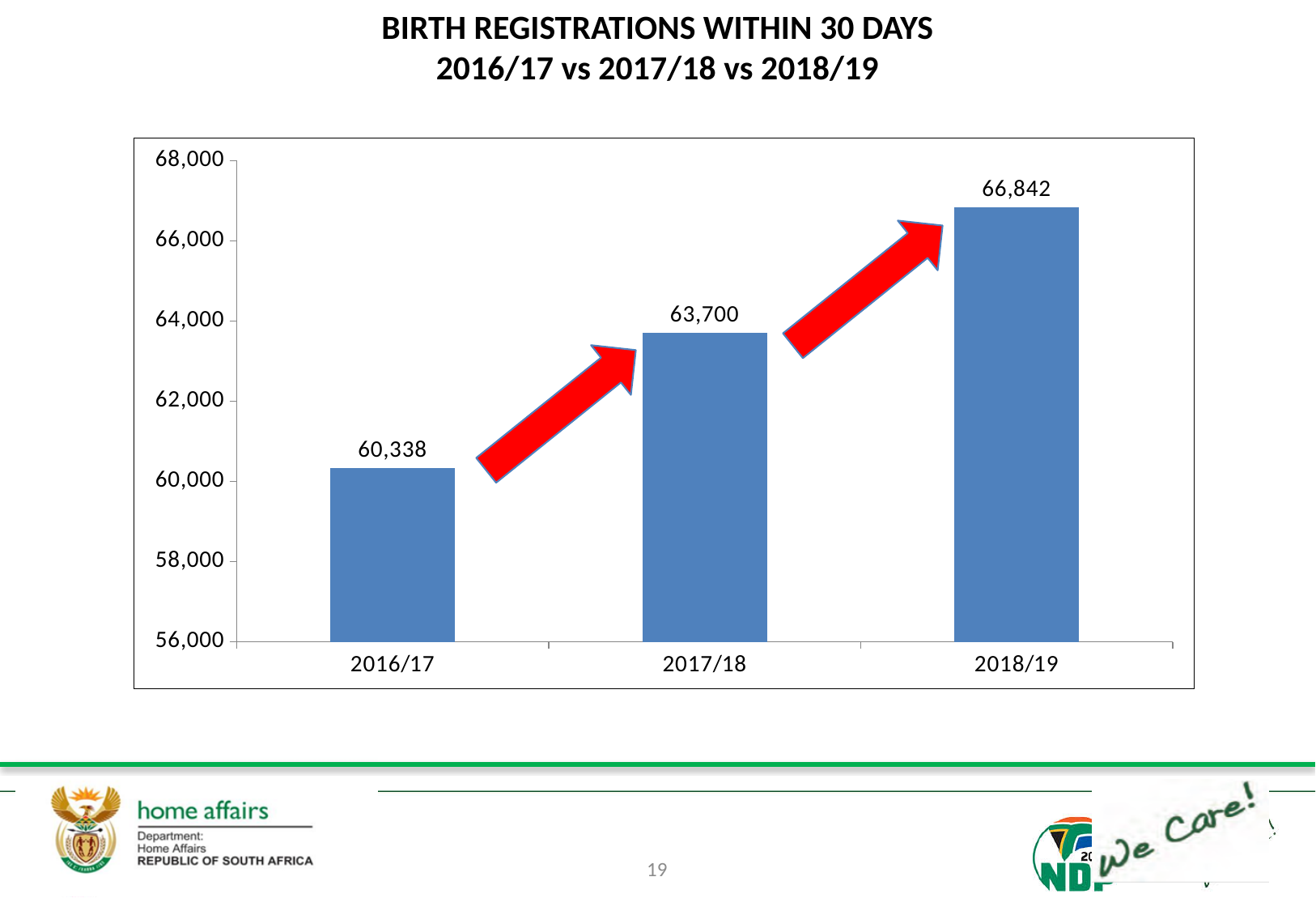
Is the value for 2017/18 greater or less than 64,000? less Do the values rise or fall from 2016/17 to 2018/19? rise What is the value for 2018/19? 66,842 Which year has the lowest number of birth registrations within 30 days? 2016/17 What is the difference between the values for 2018/19 and 2016/17? 6,504 What is the difference between the values for 2017/18 and 2016/17? 3,362 How many years are shown on the chart? 3 What is the value for 2017/18? 63,700 Which year has the highest number of birth registrations within 30 days? 2018/19 Which is larger, the value for 2017/18 or the value for 2018/19? 2018/19 What is the value for 2016/17? 60,338 What kind of chart is shown on the slide? bar chart